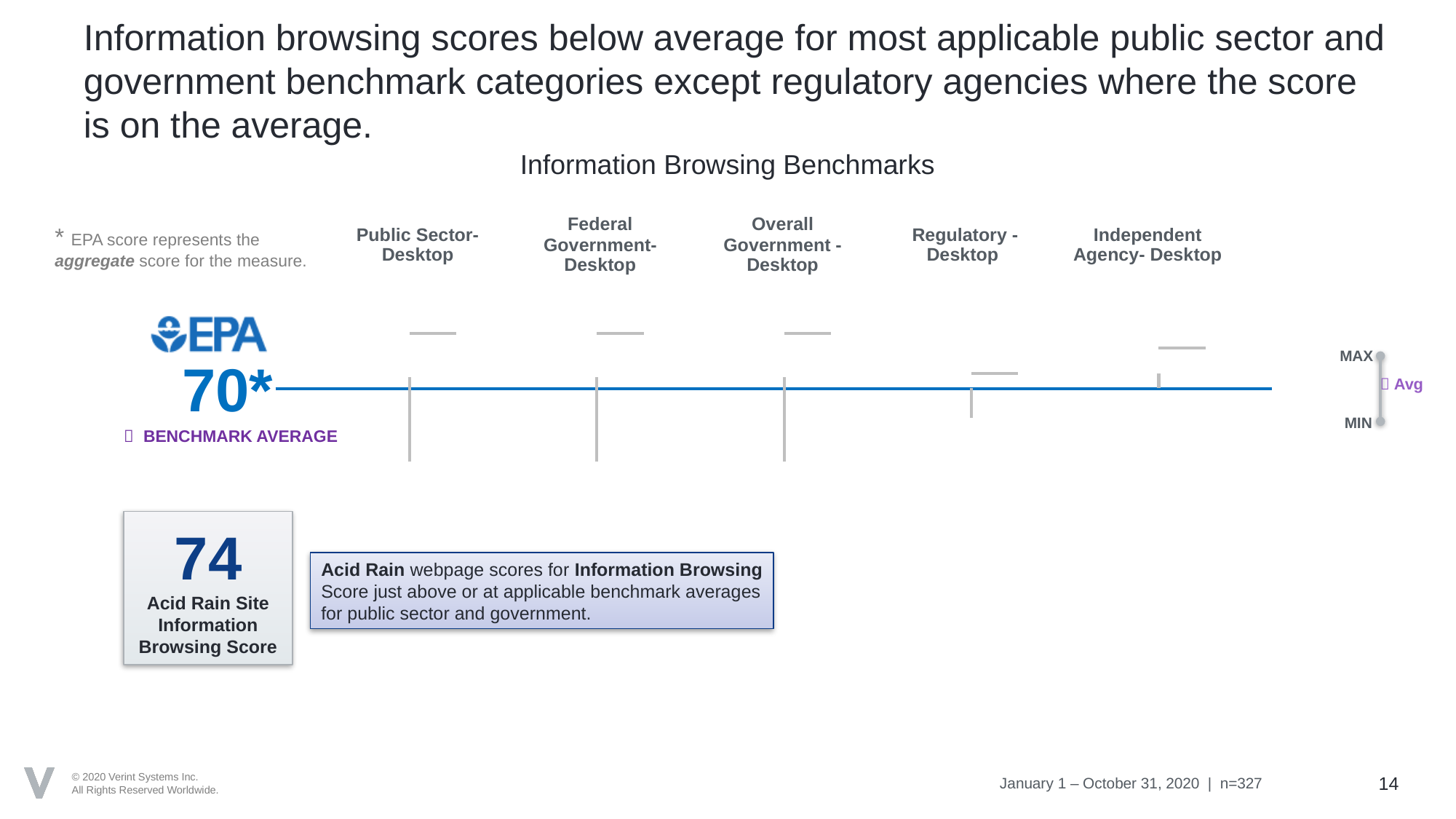
What is the Acid Rain Site Information Browsing Score? 74 Which benchmark category has the lowest MAX marker on the chart? Regulatory - Desktop Is the Acid Rain Site Information Browsing Score greater or less than 70? greater What is the difference between the Acid Rain Site Information Browsing Score (74) and the EPA aggregate score (70)? 4 What does the purple marker in the chart's key represent? Avg (benchmark average) What is the EPA aggregate score shown on the chart? 70* What is the title of the chart? Information Browsing Benchmarks How many benchmark categories are shown across the chart? 5 Which is larger, the Acid Rain Site Information Browsing Score or the EPA aggregate score? Acid Rain Site Information Browsing Score